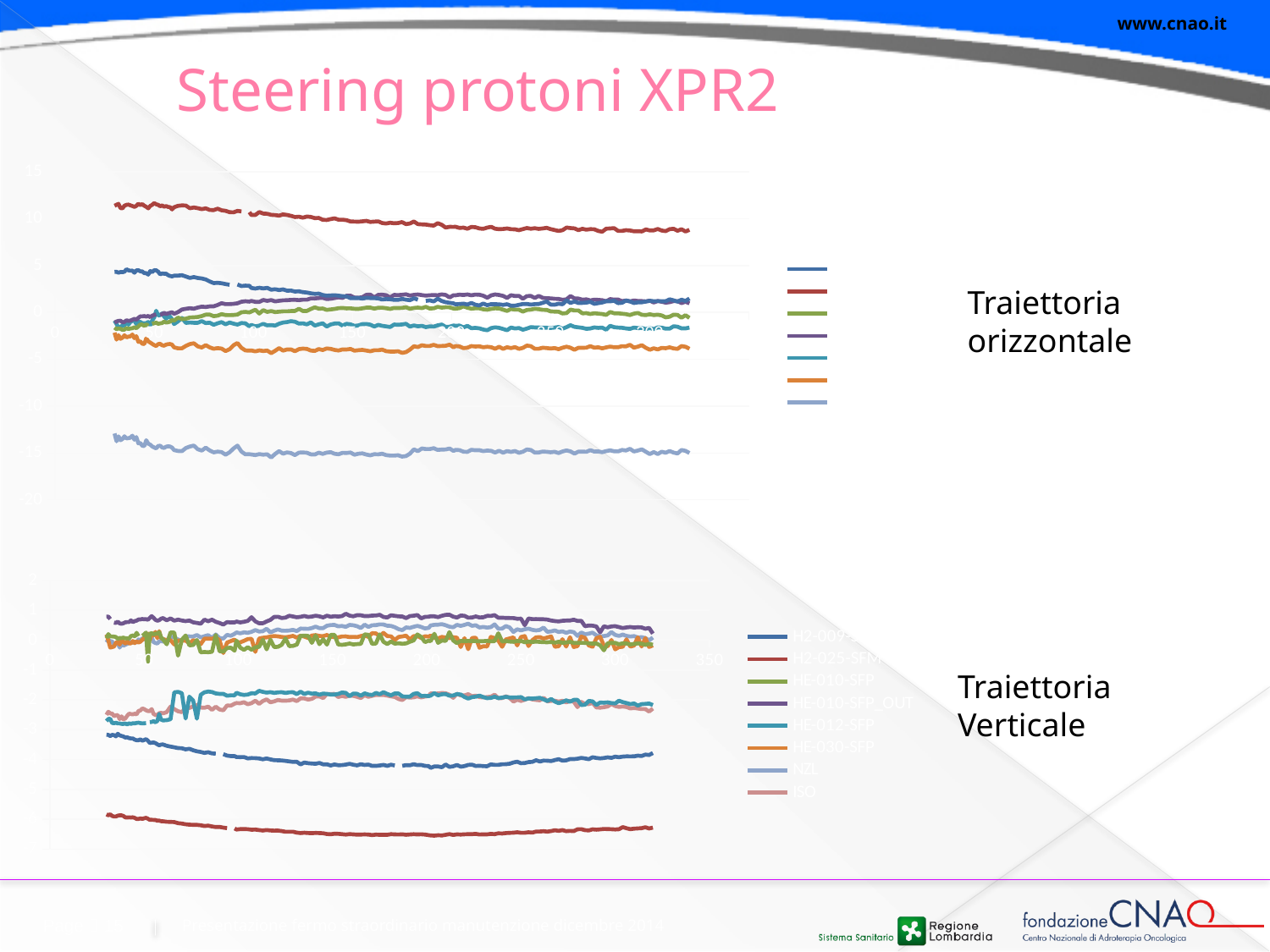
How many series does the legend of the bottom chart (Traiettoria Verticale) list? 8 In the top chart (Traiettoria orizzontale), which coloured line has the lowest values? the light blue-grey line What kind of chart is the bottom chart (Traiettoria Verticale)? line chart How many series does the legend of the top chart (Traiettoria orizzontale) list? 7 What is the label next to the top chart on the slide? Traiettoria orizzontale In the top chart (Traiettoria orizzontale), is the red line greater or less than 5? greater What kind of chart is the top chart (Traiettoria orizzontale)? line chart In the top chart (Traiettoria orizzontale), which coloured line has the highest values? the red line In the bottom chart (Traiettoria Verticale), which series has the lowest values? H2-025-SFM In the bottom chart (Traiettoria Verticale), is the red line (H2-025-SFM) greater or less than -4? less In the top chart (Traiettoria orizzontale), is the light blue-grey line at the bottom greater or less than -10? less In the top chart (Traiettoria orizzontale), does the red line rise or fall along the x axis? fall